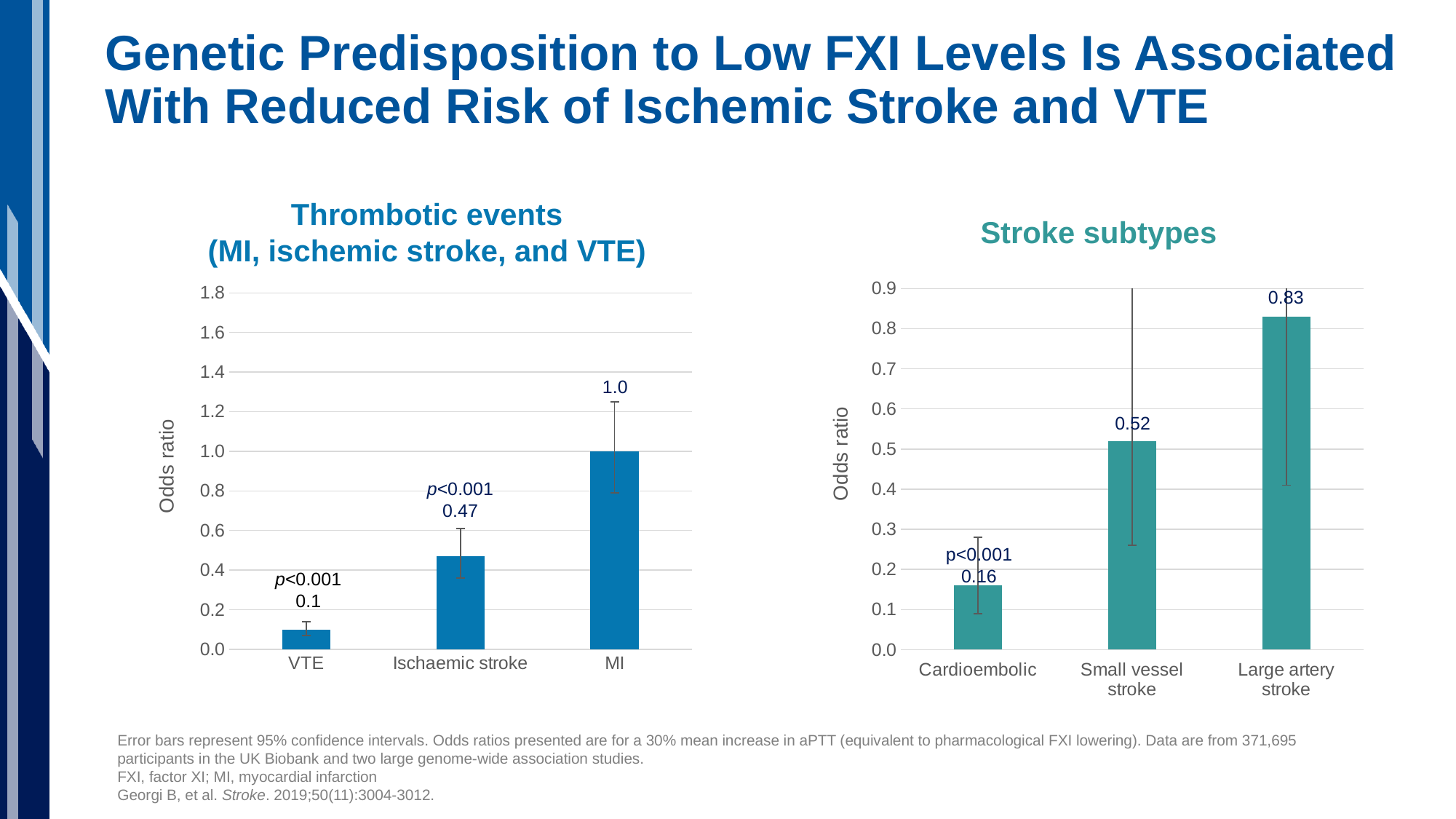
In the 'Thrombotic events' chart, what is the difference between the odds ratios for MI and Ischaemic stroke? 0.53 In the 'Thrombotic events' chart, what is the odds ratio for VTE? 0.1 In the 'Thrombotic events' chart, which category has the lowest odds ratio? VTE In the 'Stroke subtypes' chart, is the odds ratio for Small vessel stroke larger or smaller than that for Large artery stroke? smaller In the 'Stroke subtypes' chart, which category has the lowest odds ratio? Cardioembolic In the 'Stroke subtypes' chart, what is the difference between the odds ratios for Large artery stroke and Cardioembolic? 0.67 In the 'Thrombotic events' chart, how many categories are plotted? 3 In the 'Stroke subtypes' chart, what is the odds ratio for Small vessel stroke? 0.52 What type of chart is the 'Stroke subtypes' chart? bar chart In the 'Thrombotic events' chart, what is the odds ratio for Ischaemic stroke? 0.47 In the 'Thrombotic events' chart, which category has the highest odds ratio? MI In the 'Stroke subtypes' chart, what is the odds ratio for Large artery stroke? 0.83